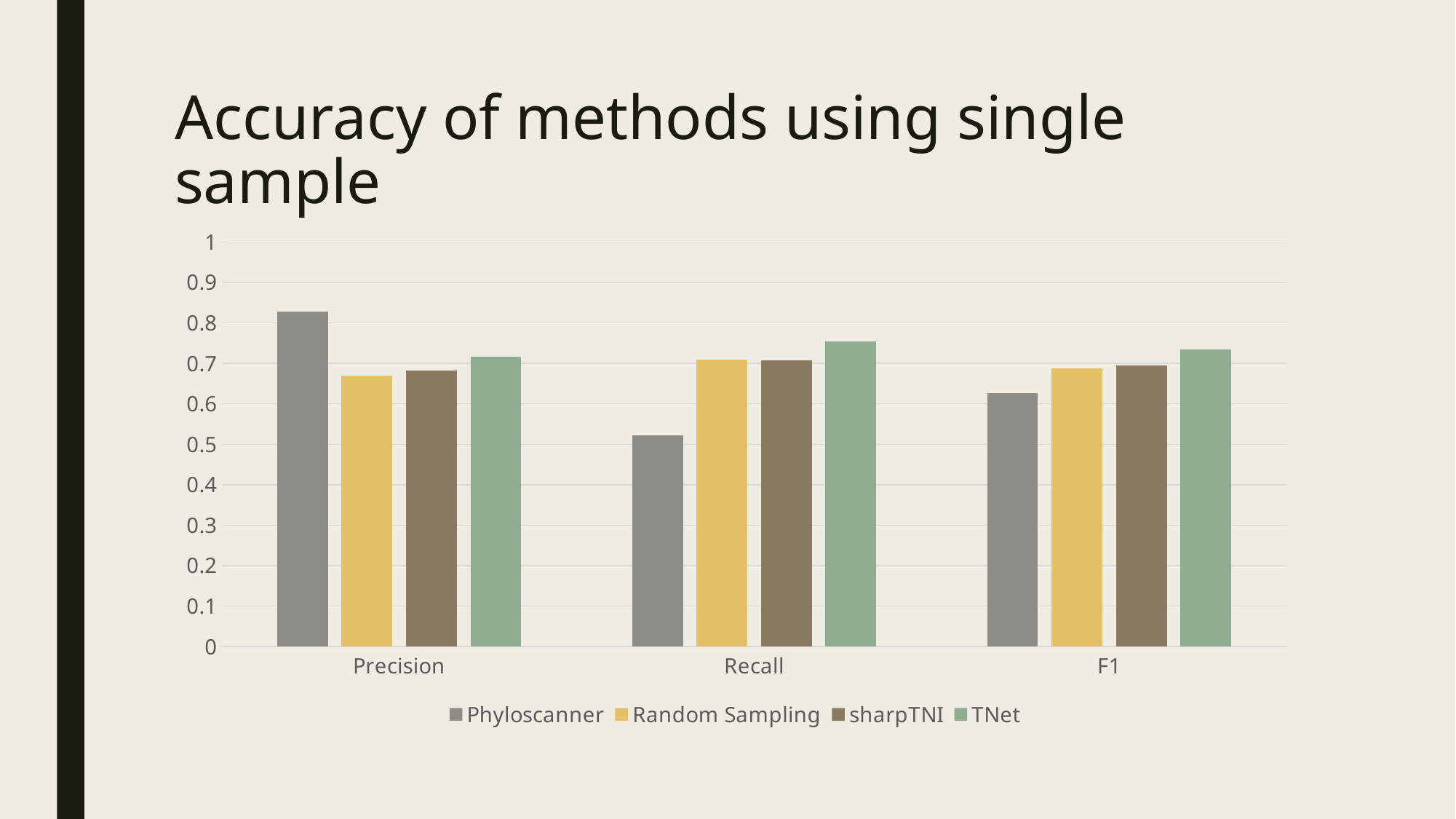
Is the Precision value for Phyloscanner greater or less than 0.8? greater Which method has the lowest Recall? Phyloscanner Which method has the highest Precision? Phyloscanner What is the title of the chart slide? Accuracy of methods using single sample For F1, which is larger: Phyloscanner or TNet? TNet Is the Recall value for Phyloscanner greater or less than 0.6? less What kind of chart is shown on the slide? bar chart Which method has the highest Recall? TNet Which series is shown in yellow in the legend? Random Sampling How many series does the legend list? 4 Is the Recall value for TNet greater or less than 0.7? greater How many categories are shown on the x axis? 3